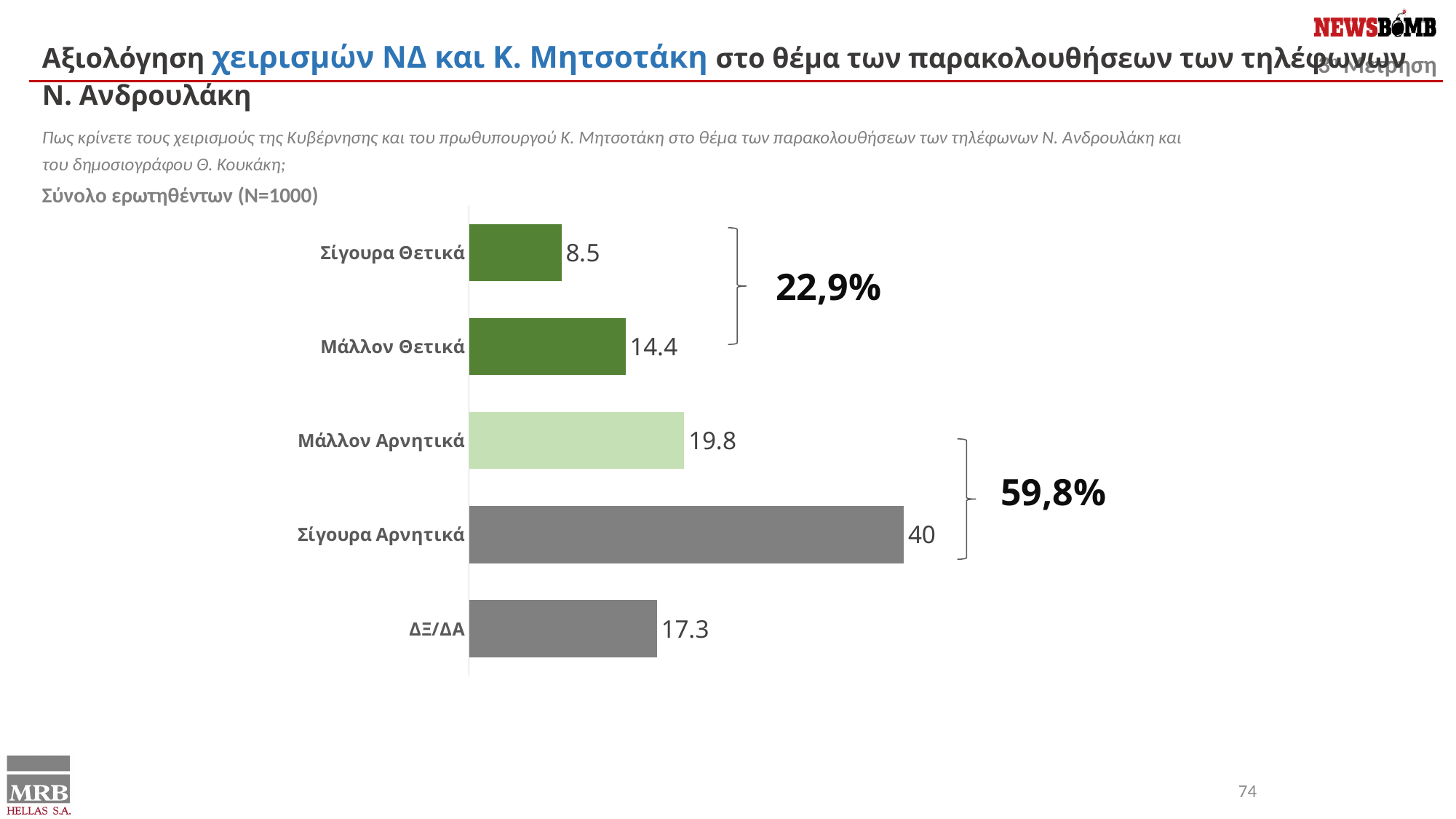
Which category has the lowest value? Σίγουρα Θετικά Which category has the highest value? Σίγουρα Αρνητικά What is the difference between the values for Σίγουρα Αρνητικά and Μάλλον Αρνητικά? 20.2 What is the value for Μάλλον Θετικά? 14.4 What is the value for Σίγουρα Θετικά? 8.5 What is the value for Μάλλον Αρνητικά? 19.8 What combined percentage is shown next to the bracket grouping the two negative categories? 59,8% What kind of chart is shown on the slide? Bar chart Which is larger, the value for Μάλλον Αρνητικά or the value for ΔΞ/ΔΑ? Μάλλον Αρνητικά What is the value for ΔΞ/ΔΑ? 17.3 How many categories are shown in the chart? 5 What is the value for Σίγουρα Αρνητικά? 40